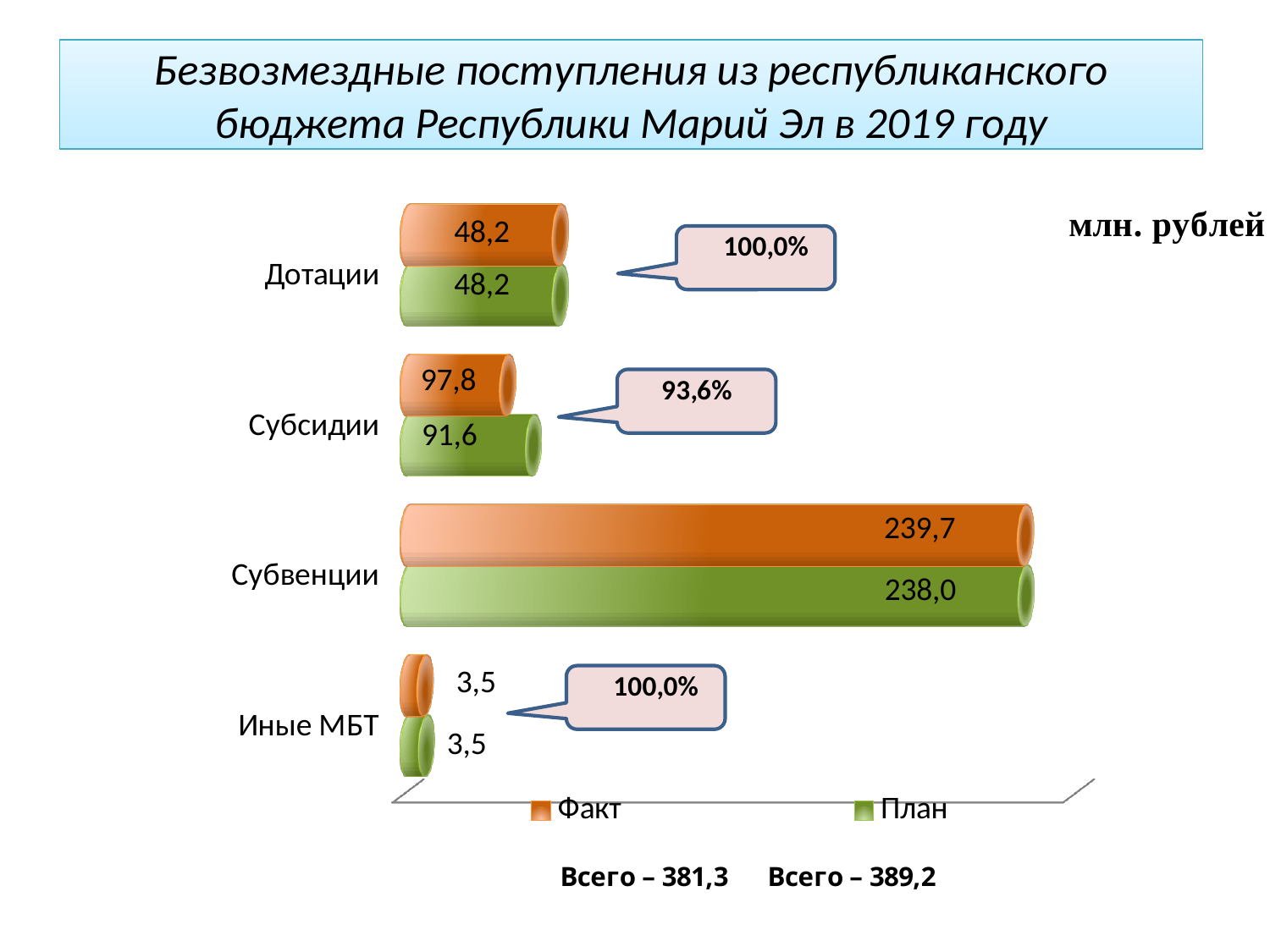
Which category has the smallest values on the chart? Иные МБТ How many categories are shown on the chart? 4 What is the value of the green bar for Дотации? 48,2 For Субсидии, which bar is larger, the orange one or the green one? the orange one What percentage is shown in the callout next to Субсидии? 93,6% What kind of chart is shown on the slide? bar chart What is the difference between the orange bar and the green bar for Субсидии? 6,2 Which category has the largest values on the chart? Субвенции What is the value of the green bar for Субвенции? 238,0 What is the value of the orange bar for Субсидии? 97,8 What are the two entries in the chart legend? Факт and План How many series does the chart legend list? 2